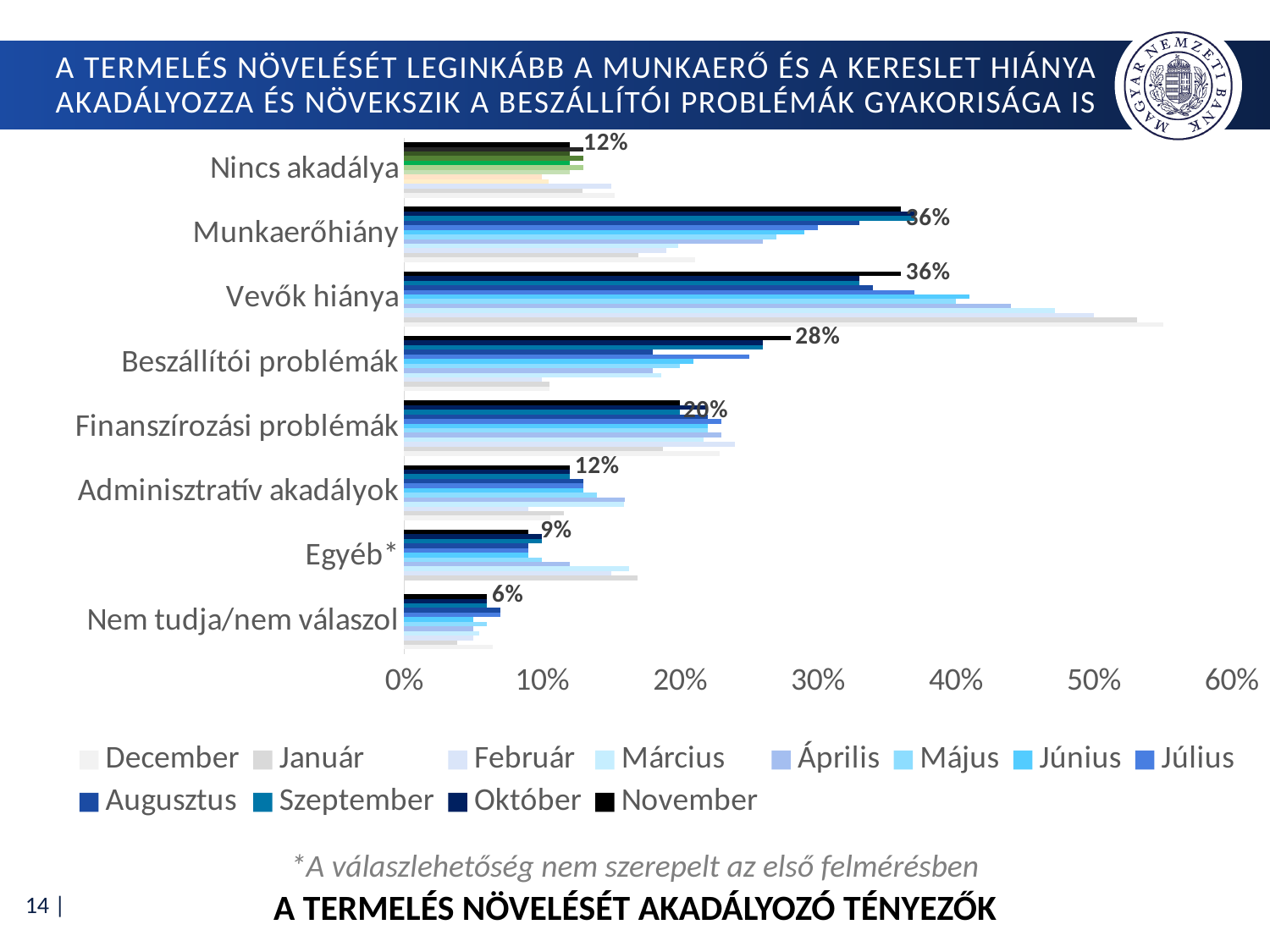
How many series does the legend list? 12 What kind of chart is shown on the slide? Bar chart What is the November value shown for Beszállítói problémák? 28% What is the November value shown for Egyéb*? 9% Which has the larger labelled November value, Beszállítói problémák or Adminisztratív akadályok? Beszállítói problémák What is the November value shown for Nem tudja/nem válaszol? 6% What is the difference between the labelled November values for Vevők hiánya and Beszállítói problémák? 8 percentage points What is the title of the chart? A TERMELÉS NÖVELÉSÉT AKADÁLYOZÓ TÉNYEZŐK Is the December value for Vevők hiánya greater or less than 50%? greater How many categories are shown on the chart? 8 Which category has the lowest labelled November value? Nem tudja/nem válaszol What is the November value shown for Munkaerőhiány? 36%